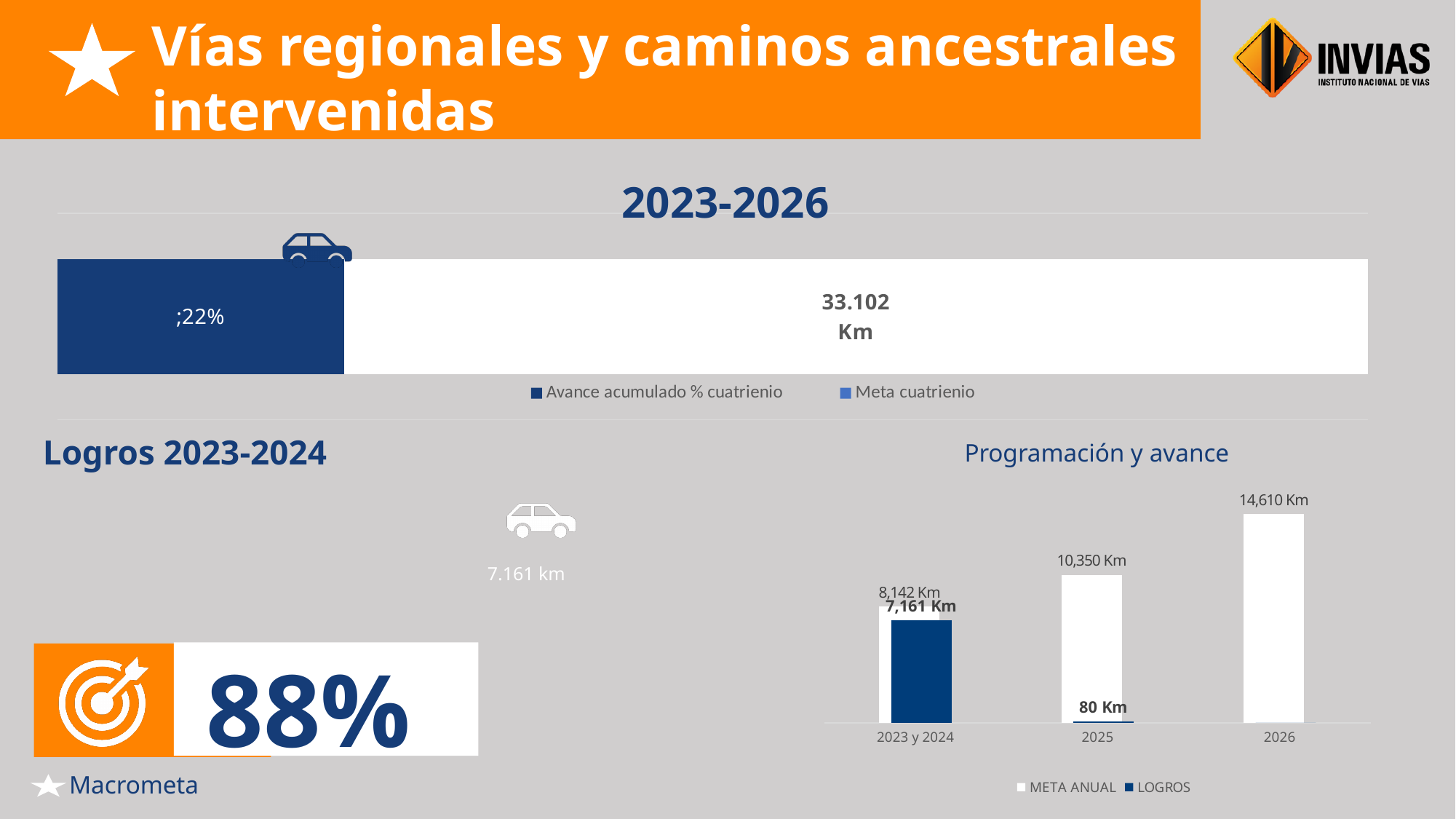
In the 'Programación y avance' chart, what is the difference between the META ANUAL values for 2026 and 2025? 4,260 Km What kind of chart is the 'Programación y avance' chart? bar chart In the '2023-2026' chart, what is the value shown for 'Meta cuatrienio'? 33.102 Km In the 'Programación y avance' chart, which year has the highest META ANUAL value? 2026 In the 'Programación y avance' chart, what is the LOGROS value for 2023 y 2024? 7,161 Km In the 'Programación y avance' chart, does the META ANUAL value rise or fall from 2023 y 2024 to 2026? rise In the 'Programación y avance' chart, what is the META ANUAL value for 2026? 14,610 Km How many series does the legend of the 'Programación y avance' chart list? 2 In the 'Programación y avance' chart, what is the difference between the META ANUAL and LOGROS values for 2023 y 2024? 981 Km In the '2023-2026' chart, what is the value shown for 'Avance acumulado % cuatrienio'? 22% In the 'Programación y avance' chart, what is the LOGROS value for 2025? 80 Km In the 'Programación y avance' chart, what is the META ANUAL value for 2025? 10,350 Km